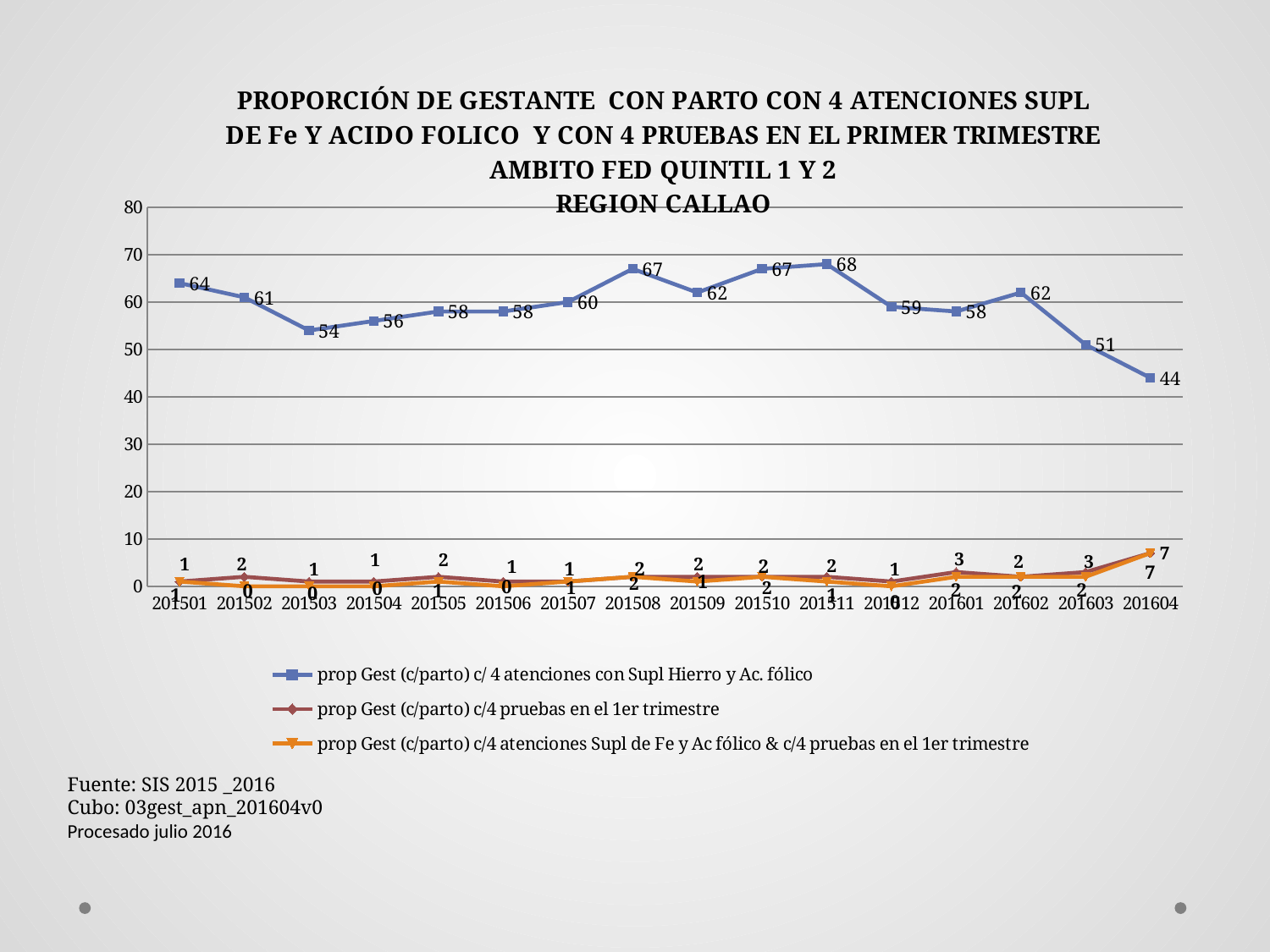
What kind of chart is shown on the slide? line chart For 'prop Gest (c/parto) c/ 4 atenciones con Supl Hierro y Ac. fólico', which period has the larger value, 201508 or 201509? 201508 How many periods are plotted along the x axis? 16 In which period does 'prop Gest (c/parto) c/ 4 atenciones con Supl Hierro y Ac. fólico' reach its highest value? 201511 What is the difference between the 201511 and 201604 values of 'prop Gest (c/parto) c/ 4 atenciones con Supl Hierro y Ac. fólico'? 24 How many series does the legend list? 3 What is the value of 'prop Gest (c/parto) c/4 pruebas en el 1er trimestre' for 201604? 7 Does 'prop Gest (c/parto) c/ 4 atenciones con Supl Hierro y Ac. fólico' rise or fall from 201602 to 201604? fall Is the 201604 value of 'prop Gest (c/parto) c/ 4 atenciones con Supl Hierro y Ac. fólico' greater or less than 50? less In which period does 'prop Gest (c/parto) c/ 4 atenciones con Supl Hierro y Ac. fólico' reach its lowest value? 201604 What is the value of 'prop Gest (c/parto) c/ 4 atenciones con Supl Hierro y Ac. fólico' for 201501? 64 Which region does the chart title say the data is for? REGION CALLAO